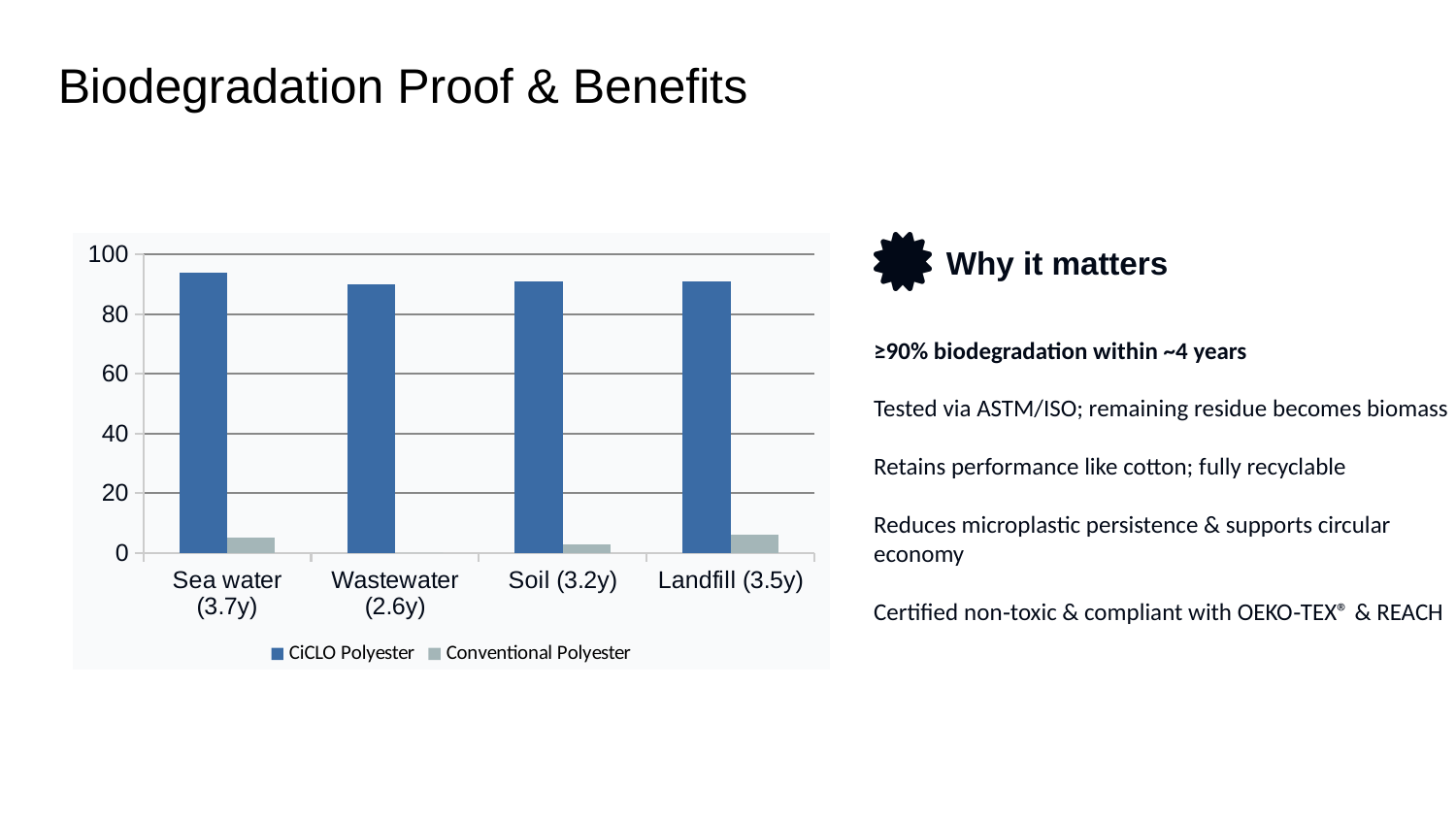
For Landfill (3.5y), which series has the larger value, CiCLO Polyester or Conventional Polyester? CiCLO Polyester Which two series are listed in the chart legend? CiCLO Polyester and Conventional Polyester How many categories are shown on the x axis of the chart? 4 Is the Conventional Polyester value for Landfill (3.5y) greater or less than 20? less What kind of chart is shown on the slide? bar chart Which category has the lowest Conventional Polyester value? Wastewater (2.6y) For Soil (3.2y), which series has the larger value, CiCLO Polyester or Conventional Polyester? CiCLO Polyester What is the highest value shown on the chart's vertical axis? 100 Is the Conventional Polyester value for Sea water (3.7y) greater or less than 20? less Is the CiCLO Polyester value for Wastewater (2.6y) greater or less than 60? greater How many series does the chart legend list? 2